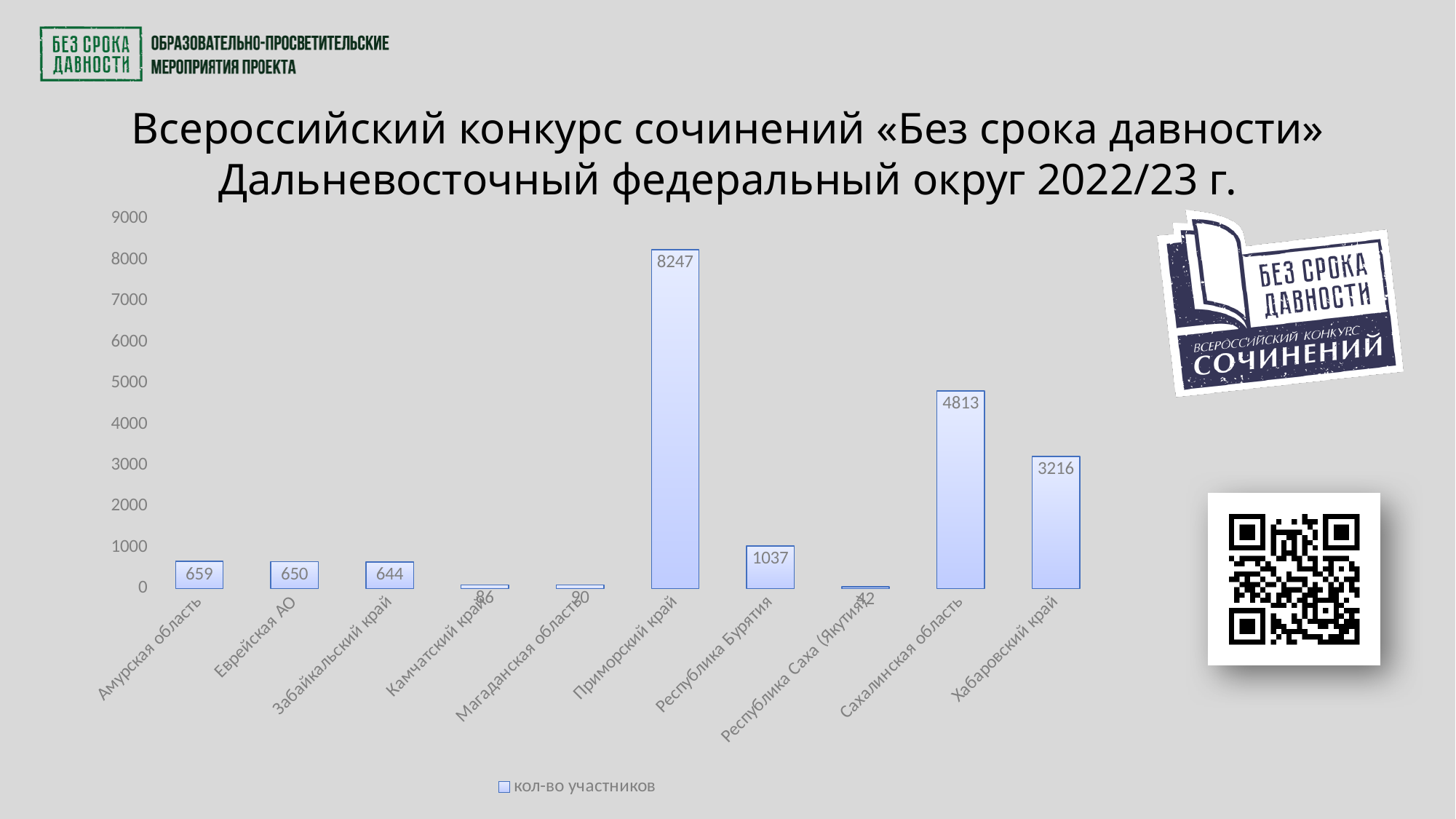
What is the difference between the values for Приморский край and Сахалинская область? 3434 What kind of chart is shown? bar chart What is the value for Сахалинская область? 4813 Which is larger, the value for Хабаровский край or for Сахалинская область? Сахалинская область Which region has the highest value? Приморский край How many series does the legend list? 1 What is the value for Республика Бурятия? 1037 Is the value for Камчатский край greater or less than 1000? less What is the value for Хабаровский край? 3216 What is the value for Приморский край? 8247 What is the value for Амурская область? 659 How many regions are shown on the x axis? 10